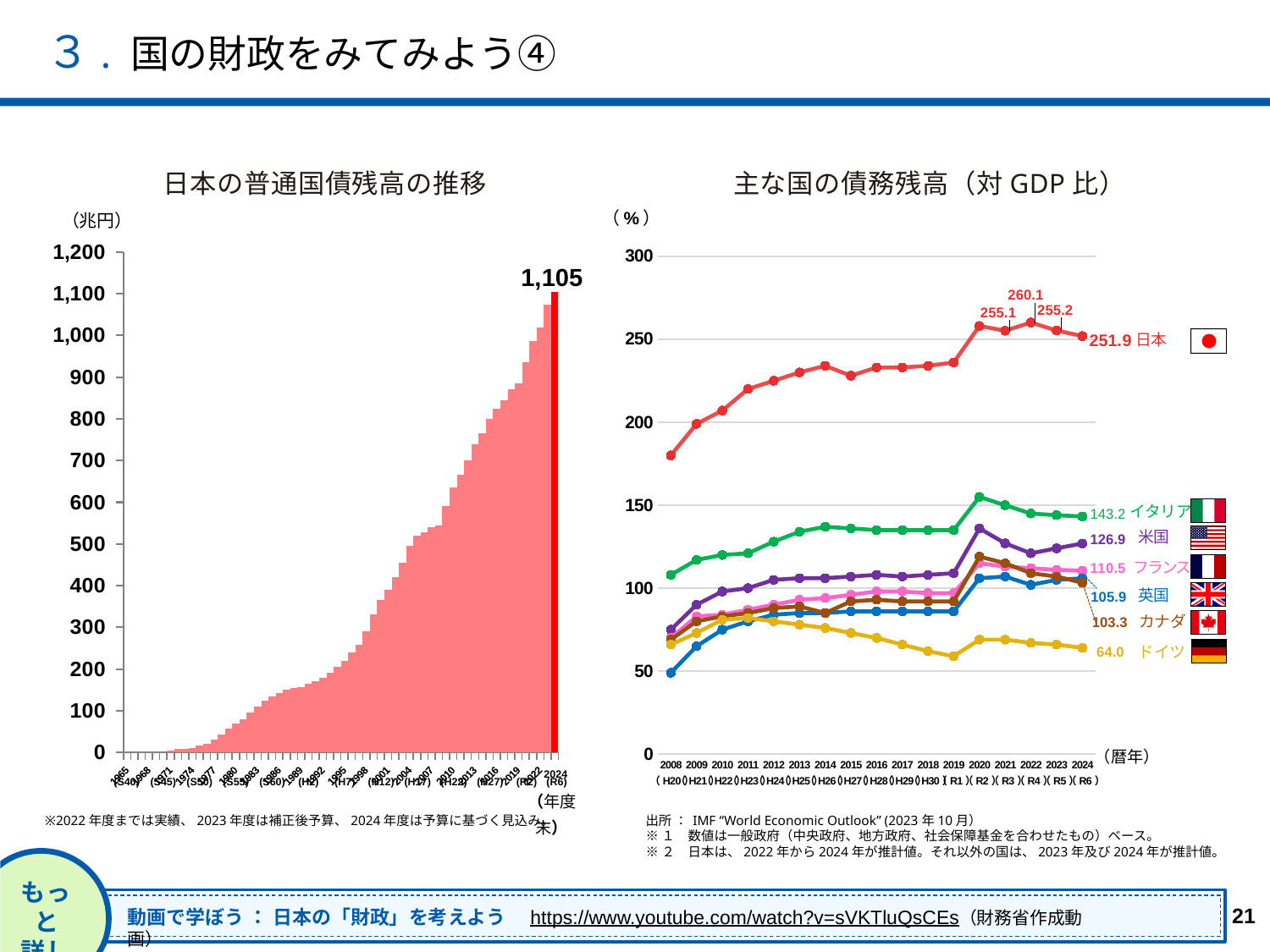
In the chart titled 主な国の債務残高（対GDP比）, which country has the highest value in 2024? 日本 In the chart titled 主な国の債務残高（対GDP比）, which is larger in 2024, the value for フランス or the value for 英国? フランス In the chart titled 主な国の債務残高（対GDP比）, what is the difference between the 2024 values for イタリア and 米国? 16.3 In the chart titled 主な国の債務残高（対GDP比）, what is the value for 日本 in 2024? 251.9 In the chart titled 日本の普通国債残高の推移, what is the value shown for 2024? 1,105 In the chart titled 主な国の債務残高（対GDP比）, what is the value for 日本 in 2022? 260.1 What kind of chart is the chart titled 日本の普通国債残高の推移? bar chart In the chart titled 日本の普通国債残高の推移, is the value for 2024 greater or less than 1,000? greater In the chart titled 主な国の債務残高（対GDP比）, how many countries are plotted? 7 In the chart titled 主な国の債務残高（対GDP比）, what is the value for ドイツ in 2024? 64.0 In the chart titled 主な国の債務残高（対GDP比）, which country has the lowest value in 2024? ドイツ In the chart titled 日本の普通国債残高の推移, do the values generally rise or fall from left to right along the x axis? rise